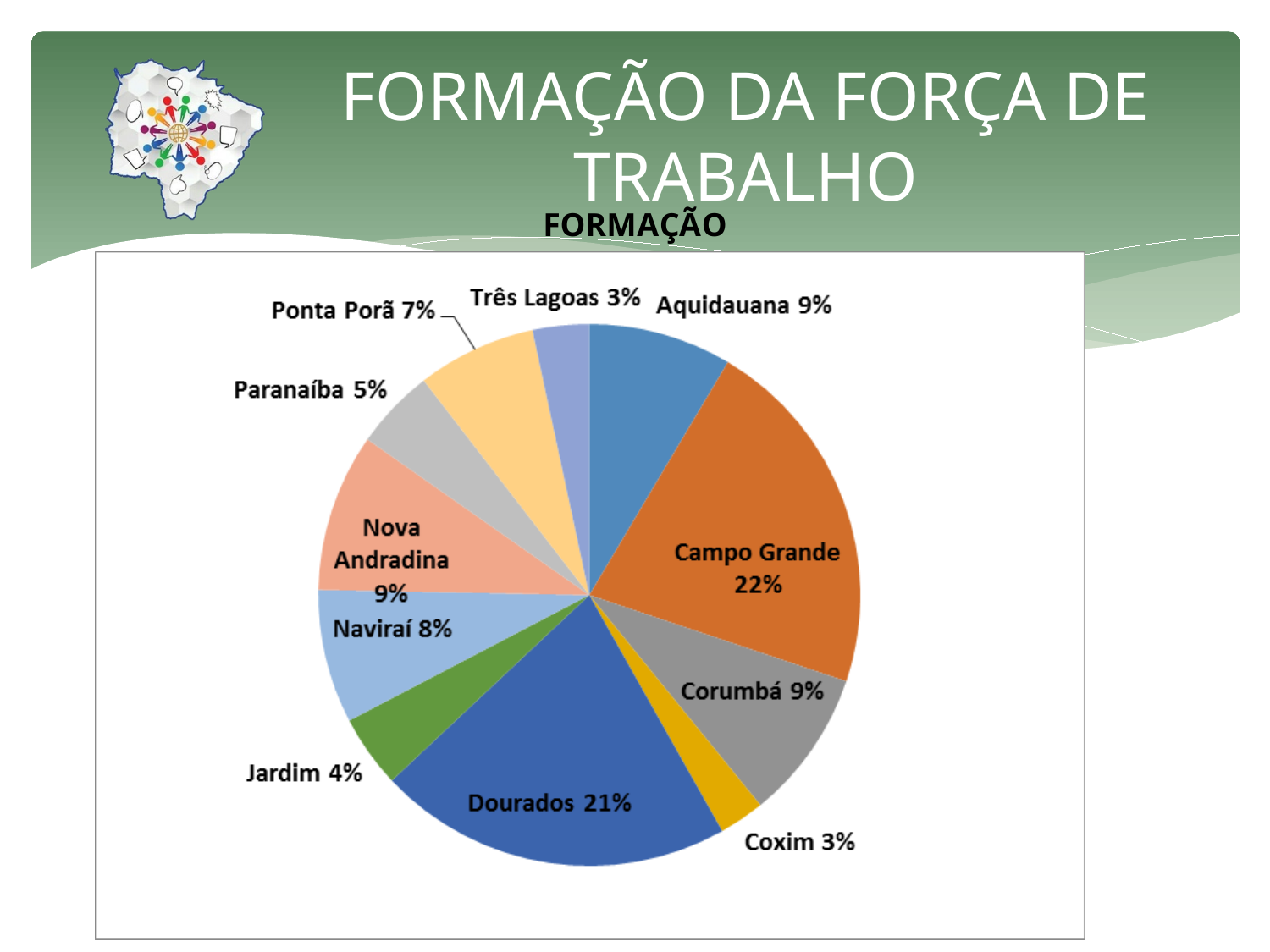
What is the value shown for Ponta Porã? 7% What is the difference between the shares of Campo Grande and Dourados? 1% What kind of chart is shown on the slide? pie chart What is the value shown for Paranaíba? 5% What is the title of the chart? FORMAÇÃO Which category has the largest share of the pie? Campo Grande Which has a larger share, Jardim or Nova Andradina? Nova Andradina How many slices does the pie chart have? 11 What share of the pie does Campo Grande have? 22% What share of the pie does Dourados have? 21% What is the value shown for Naviraí? 8% What is the difference between the shares of Aquidauana and Coxim? 6%